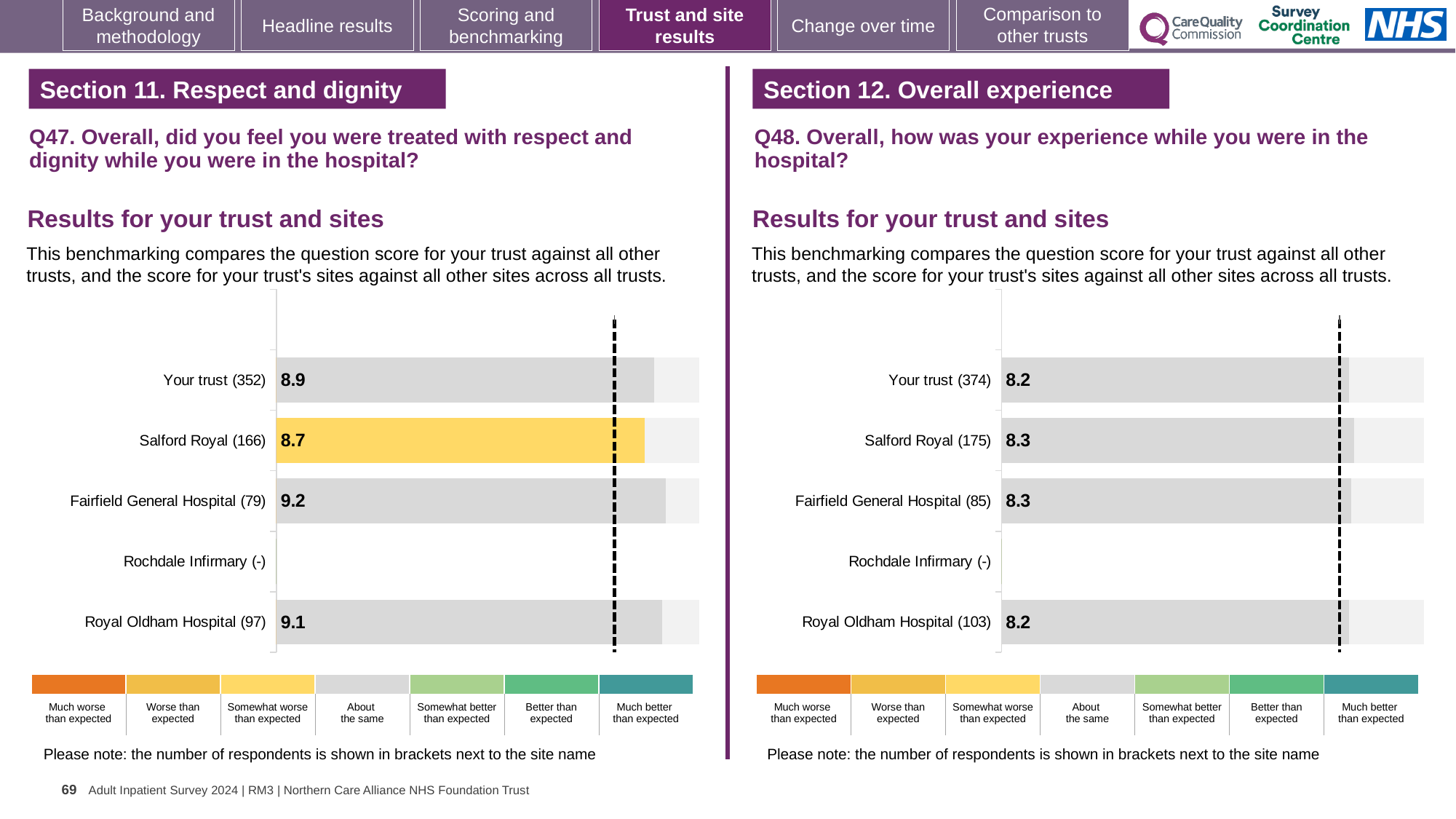
In the Q48 chart on the right, what is the score for Royal Oldham Hospital? 8.2 In the Q47 chart on the left, which site has the lowest score? Salford Royal How many sites or rows are listed in the Q48 chart on the right? 5 In the Q47 chart on the left, what is the score for Salford Royal? 8.7 In the Q47 chart on the left, what is the score for Fairfield General Hospital? 9.2 In the Q48 chart on the right, what is the difference between the scores for Salford Royal and Your trust? 0.1 In the Q47 chart on the left, what is the difference between the scores for Fairfield General Hospital and Salford Royal? 0.5 What kind of chart is used in the Q47 chart on the left? Bar chart In the Q48 chart on the right, what is the score for Your trust? 8.2 In the Q47 chart on the left, which site has the highest score? Fairfield General Hospital In the Q47 chart on the left, which has the higher score, Royal Oldham Hospital or Your trust? Royal Oldham Hospital In the Q47 chart on the left, which site's bar is coloured yellow? Salford Royal